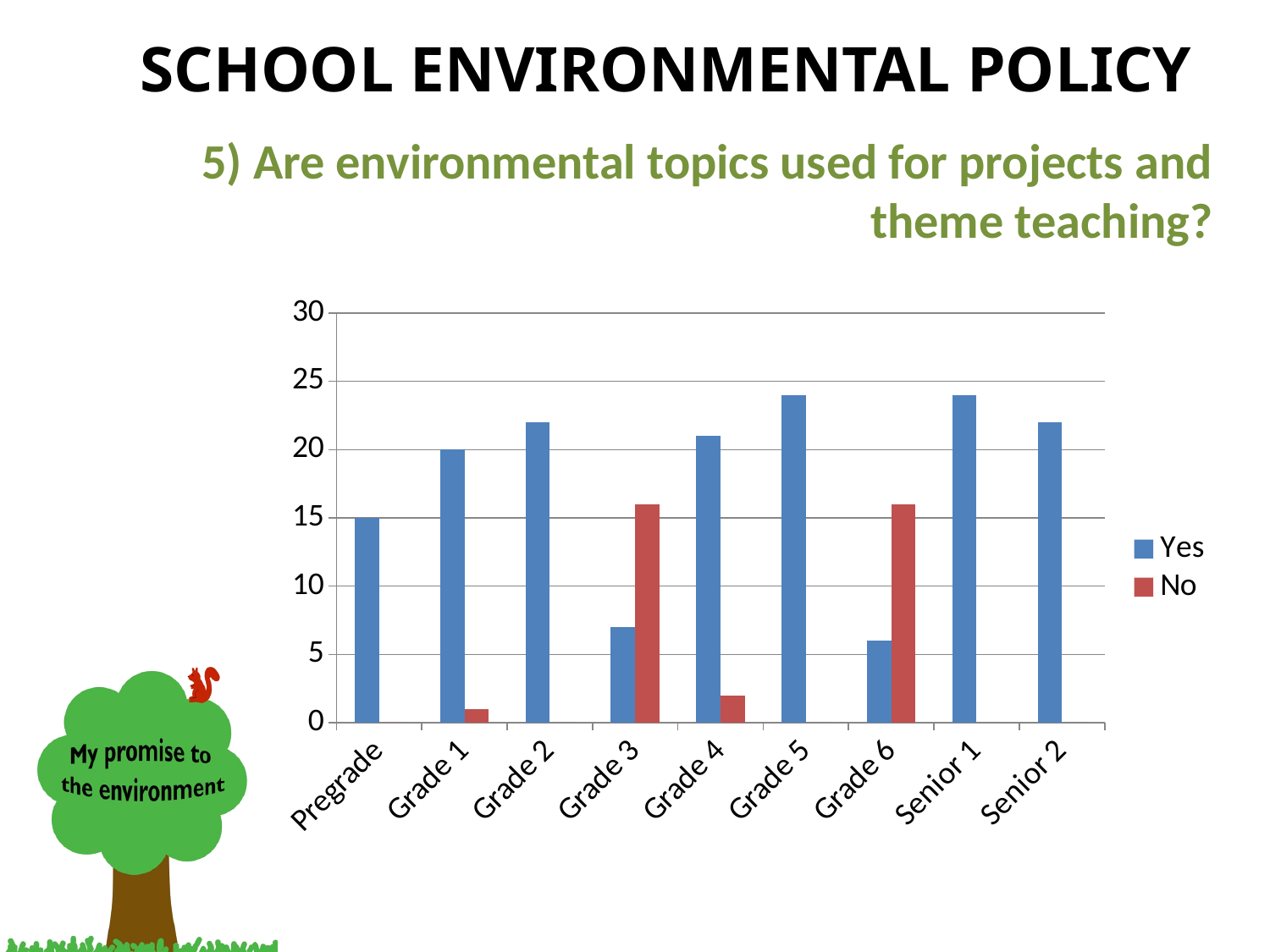
What is the Yes value for Pregrade? 15 Is the Yes value for Senior 2 greater or less than 25? less What are the two entries in the chart legend? Yes and No How many grade categories are shown on the x axis? 9 Which is larger, the Yes value for Grade 2 or the Yes value for Grade 3? Grade 2 What is the Yes value for Grade 1? 20 Is the Yes value for Grade 3 greater or less than 10? less Is the No value for Grade 6 greater or less than 15? greater Which is larger, the No value for Grade 3 or the No value for Grade 4? Grade 3 How many series does the legend list? 2 What kind of chart is shown on the slide? bar chart